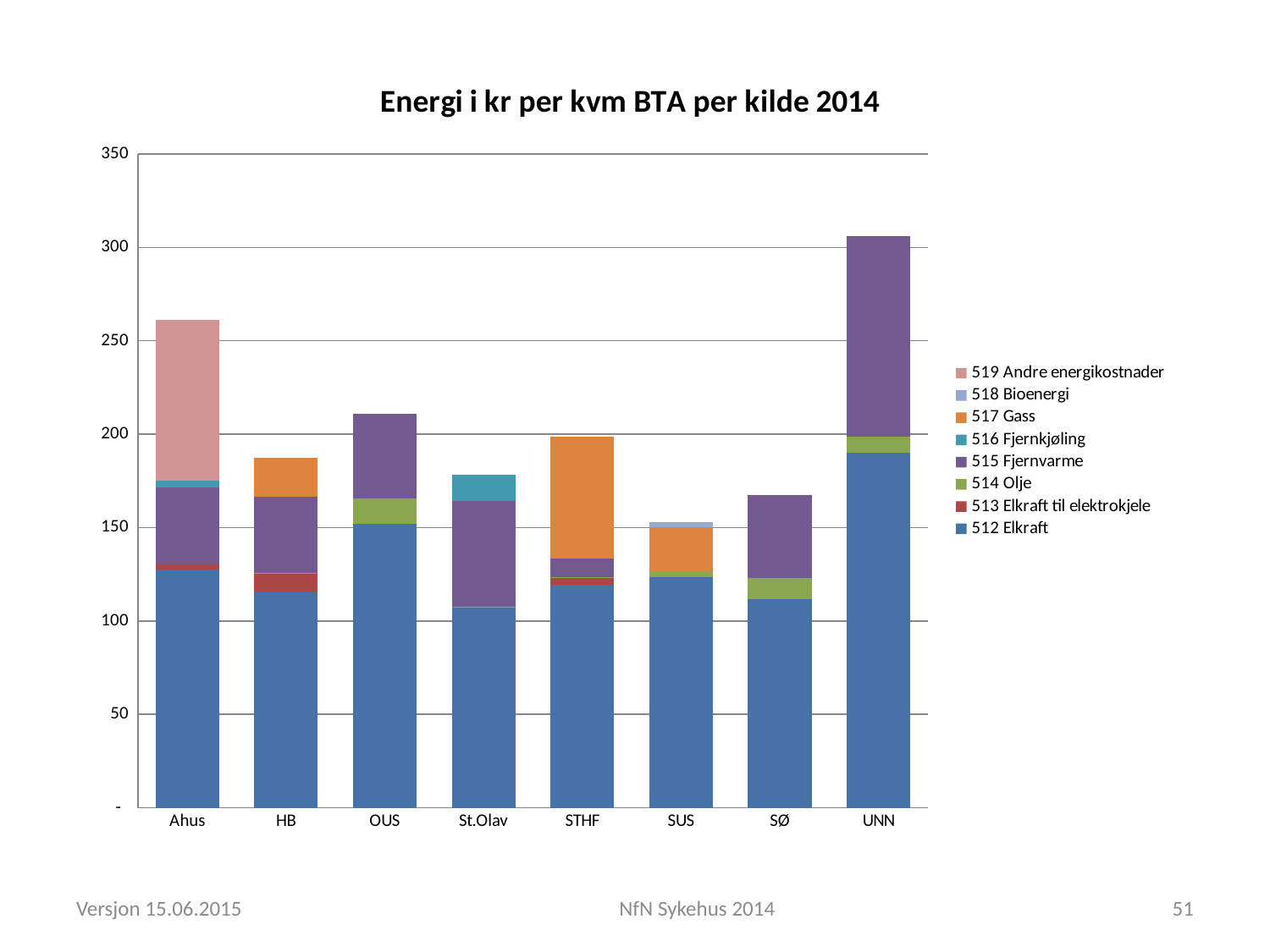
How many series does the legend list? 8 Which has the larger total bar, Ahus or OUS? Ahus How many categories are shown on the x axis? 8 Is the total value for St.Olav greater or less than 200? less Is the total value for HB greater or less than 150? greater Which category has the highest total stacked bar? UNN Is the total value for Ahus greater or less than 250? greater What is the title of the chart? Energi i kr per kvm BTA per kilde 2014 Which category has the lowest total stacked bar? SUS Which category has the largest 517 Gass segment? STHF What kind of chart is shown on the slide? Stacked bar chart Which category is the only one with a 519 Andre energikostnader segment? Ahus